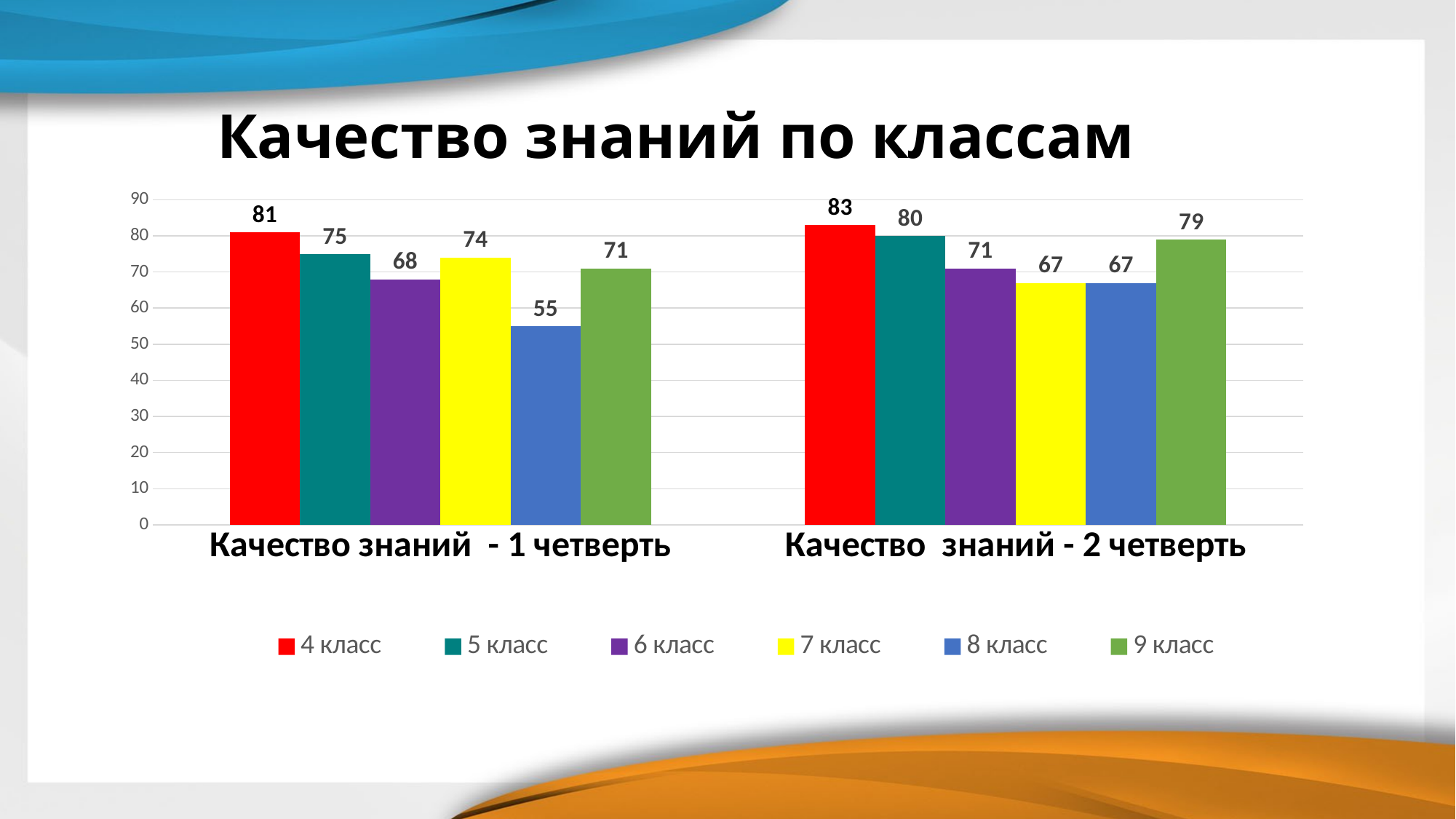
How many category groups are shown on the x axis? 2 What colour represents 7 класс in the legend? Yellow What is the value for 4 класс in the 'Качество знаний - 1 четверть' group? 81 What kind of chart is shown on the slide? Bar chart What is the value for 8 класс in the 'Качество знаний - 2 четверть' group? 67 Which class has the lowest value in the 'Качество знаний - 1 четверть' group? 8 класс What is the difference between the 8 класс values in the 2nd quarter and the 1st quarter? 12 What is the value for 9 класс in the 'Качество знаний - 1 четверть' group? 71 Which class has the highest value in the 'Качество знаний - 2 четверть' group? 4 класс How many series does the legend list? 6 What is the title of the slide? Качество знаний по классам Which is larger: the 7 класс value in the 1st quarter or in the 2nd quarter? 1st quarter (74)